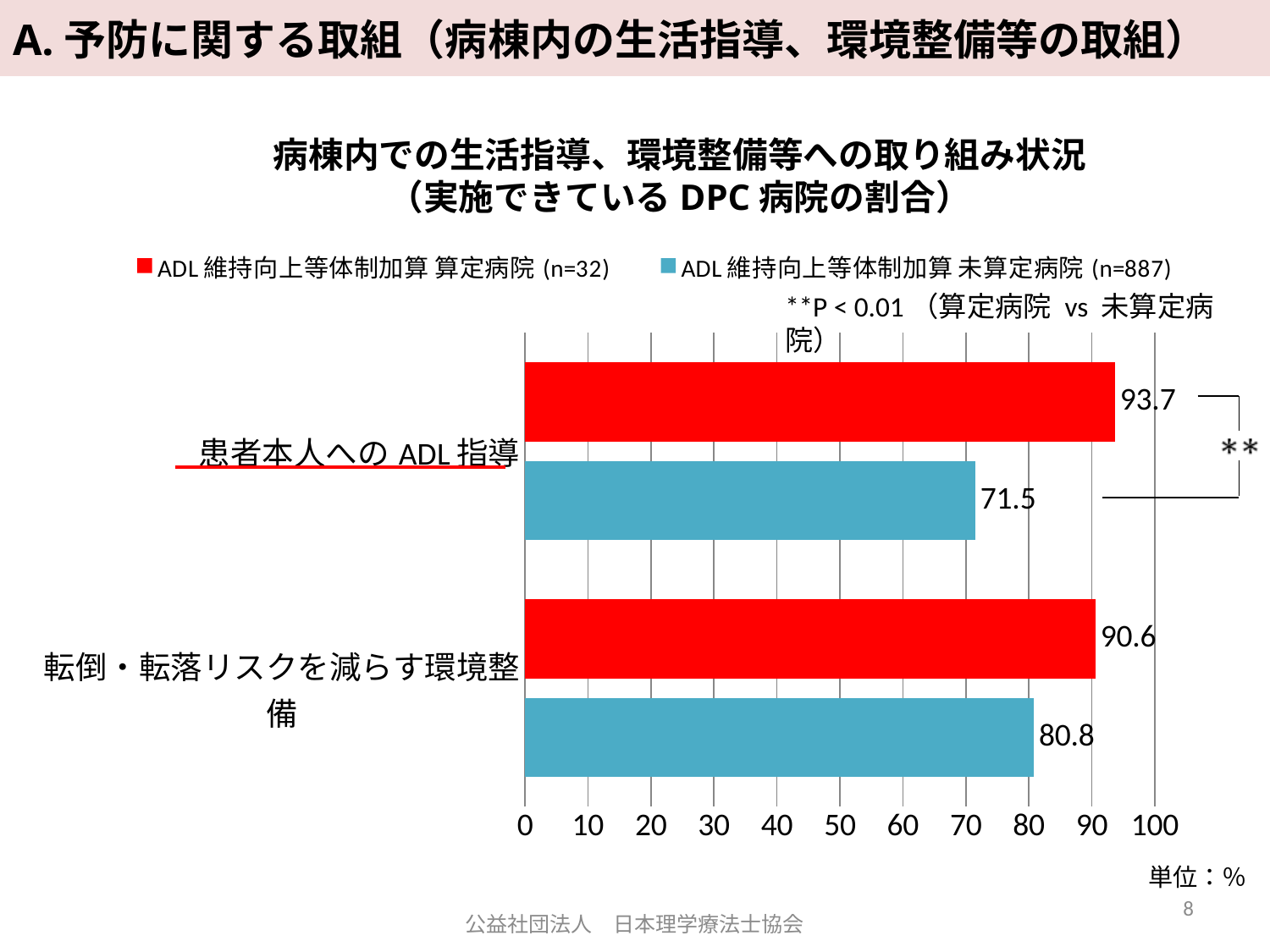
What is the value for ADL維持向上等体制加算 未算定病院 (n=887) for 患者本人へのADL指導? 71.5 What type of chart is shown on the slide? bar chart What unit is indicated for the chart values? % How many categories are shown on the chart? 2 What is the difference between the 算定病院 and 未算定病院 values for 転倒・転落リスクを減らす環境整備? 9.8 What is the value for ADL維持向上等体制加算 算定病院 (n=32) for 転倒・転落リスクを減らす環境整備? 90.6 Which category has the lowest value for ADL維持向上等体制加算 未算定病院 (n=887)? 患者本人へのADL指導 How many series does the legend list? 2 Which is larger for 転倒・転落リスクを減らす環境整備: the 算定病院 value or the 未算定病院 value? 算定病院 What is the value for ADL維持向上等体制加算 未算定病院 (n=887) for 転倒・転落リスクを減らす環境整備? 80.8 What is the value for ADL維持向上等体制加算 算定病院 (n=32) for 患者本人へのADL指導? 93.7 What is the difference between the 算定病院 and 未算定病院 values for 患者本人へのADL指導? 22.2